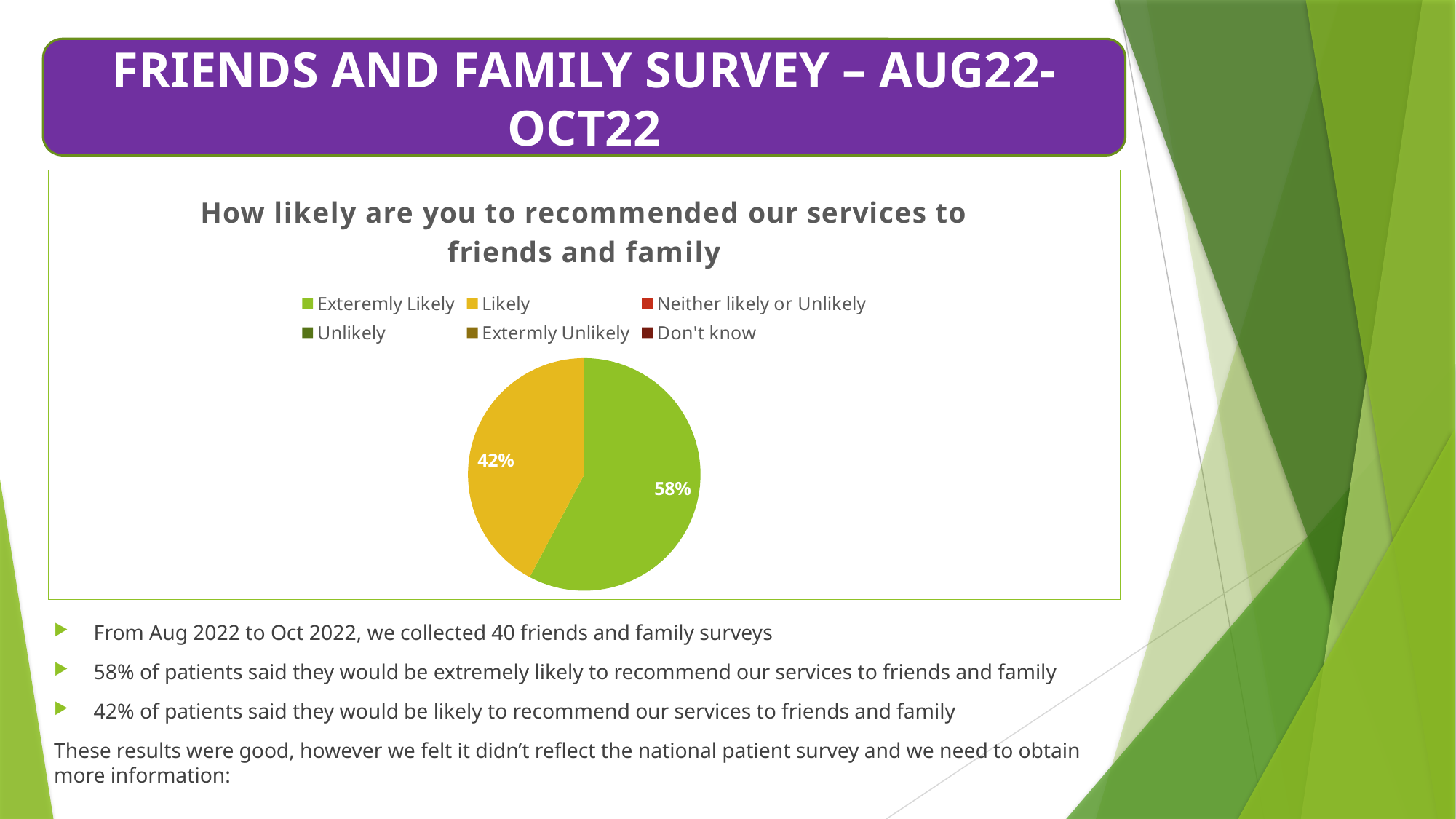
What share of the pie is labelled for the Likely slice? 42% What do the two labelled slices of the pie add up to? 100% What is the difference in percentage points between the Exteremly Likely slice and the Likely slice? 16% How many entries does the chart legend list? 6 What kind of chart is shown on the slide? Pie chart What share of the pie is labelled for the Exteremly Likely slice? 58% Which of the two labelled slices is larger, Exteremly Likely or Likely? Exteremly Likely What is the title of the chart? How likely are you to recommended our services to friends and family What colour is the Likely slice in the pie chart? Yellow Is the share for the Exteremly Likely slice greater or less than 50%? greater How many slices with data labels are visible in the pie chart? 2 Which category has the largest slice of the pie? Exteremly Likely